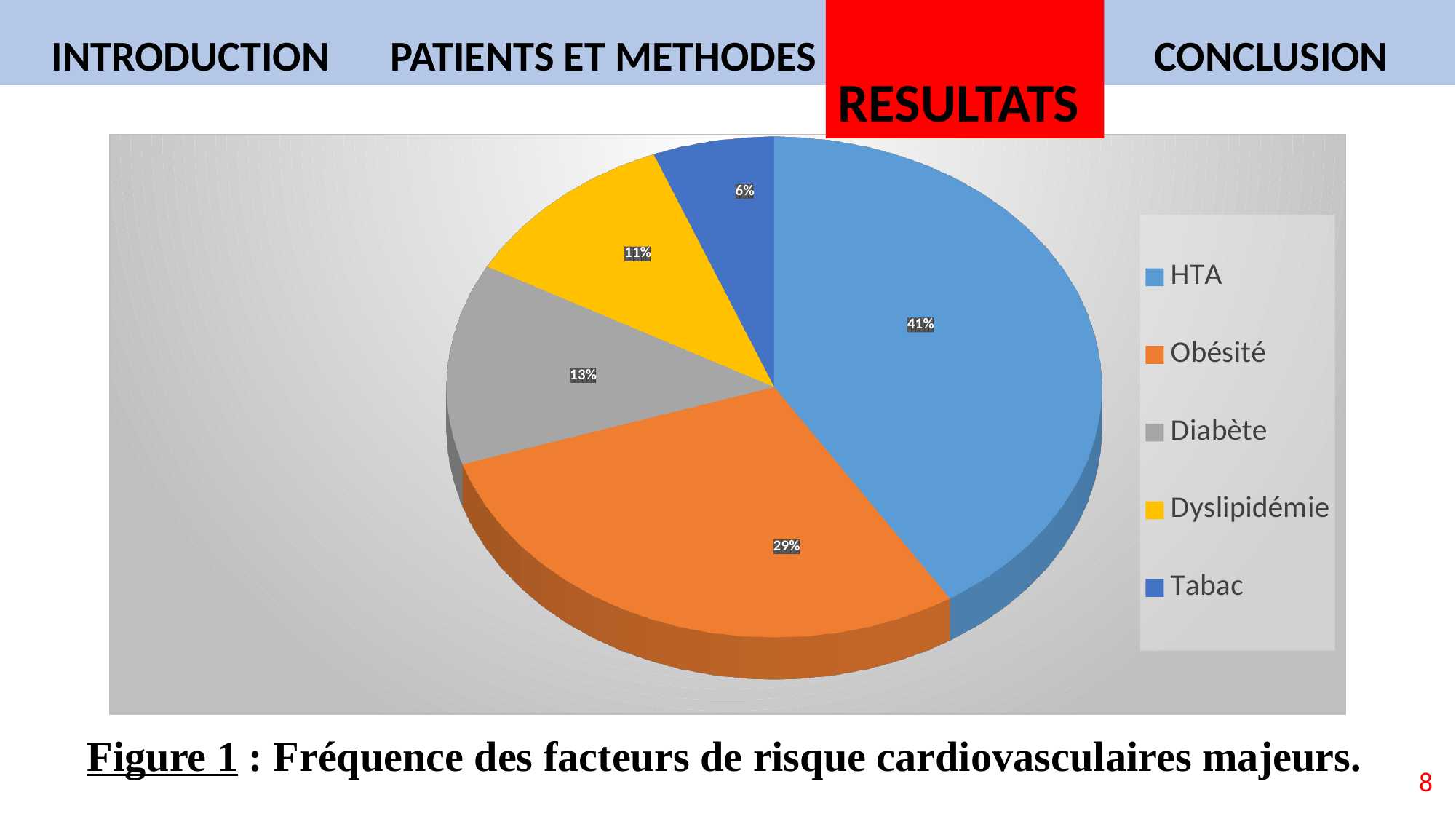
What is the value shown for Tabac? 6% What is the value shown for Dyslipidémie? 11% What type of chart is shown on the slide? Pie chart What is the value shown for Diabète? 13% What percentage of the pie does HTA represent? 41% What colour is the slice for Dyslipidémie? Yellow Which is larger, the slice for Diabète or the slice for Dyslipidémie? Diabète Which risk factor has the largest slice of the pie? HTA Which risk factor has the smallest slice of the pie? Tabac How many categories does the legend list? 5 What is the difference in percentage points between HTA and Obésité? 12 What is the value shown for Obésité? 29%